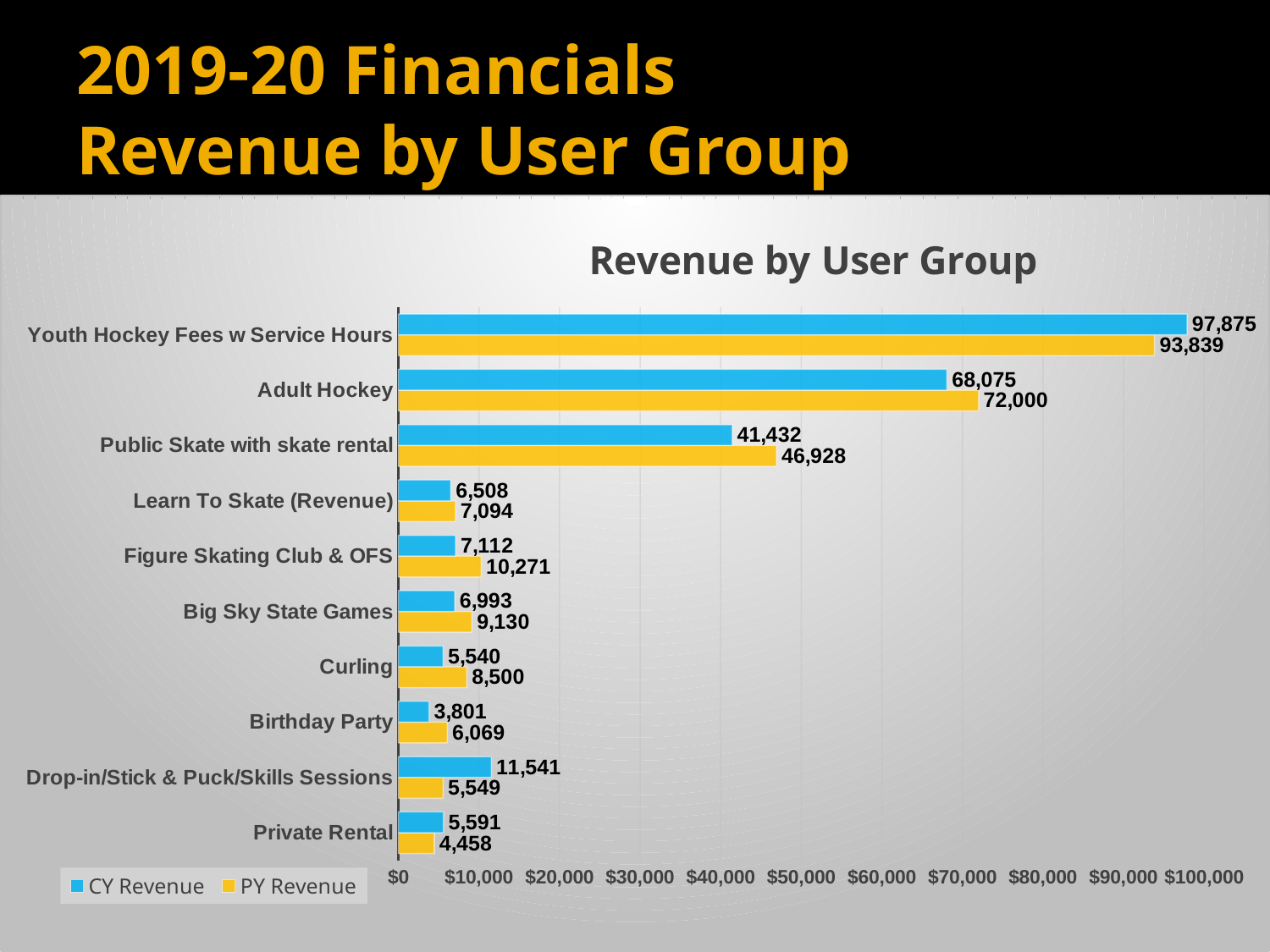
Which user group has the highest CY Revenue? Youth Hockey Fees w Service Hours How many series does the legend list? 2 What is the CY Revenue for Adult Hockey? 68,075 What is the CY Revenue for Drop-in/Stick & Puck/Skills Sessions? 11,541 How many user groups are shown in the chart? 10 Which user group has the lowest CY Revenue? Birthday Party What type of chart is shown on the slide? Bar chart Which is larger for Adult Hockey, CY Revenue or PY Revenue? PY Revenue Which user group has the lowest PY Revenue? Private Rental Is the CY Revenue for Public Skate with skate rental greater or less than $40,000? greater What is the PY Revenue for Public Skate with skate rental? 46,928 What is the difference between CY Revenue and PY Revenue for Youth Hockey Fees w Service Hours? 4,036